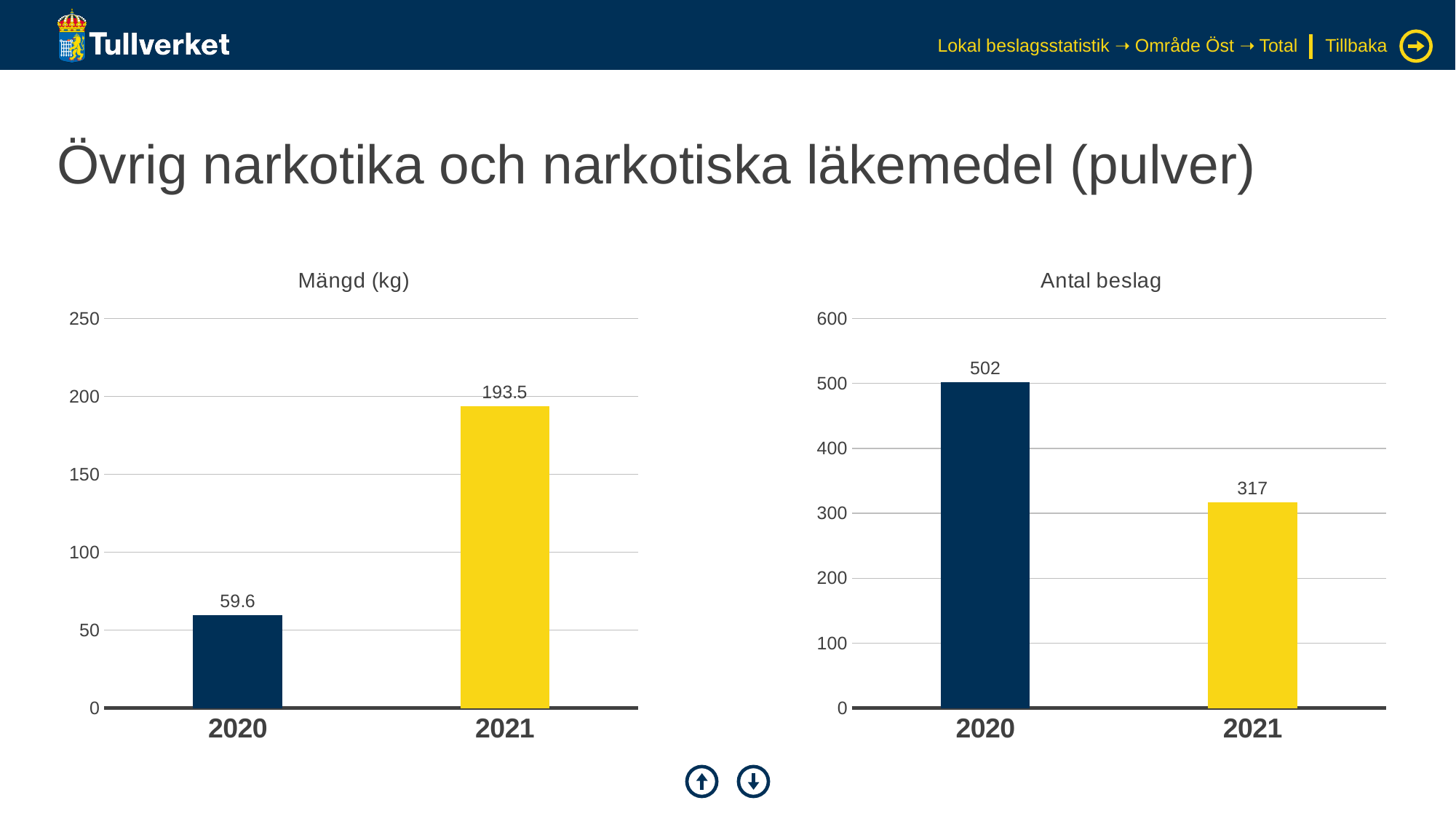
In the 'Antal beslag' chart, which year has the lowest value? 2021 In the 'Antal beslag' chart, what is the value for 2021? 317 In the 'Mängd (kg)' chart, what is the value for 2020? 59.6 In the 'Mängd (kg)' chart, what is the value for 2021? 193.5 How many bars are shown in the 'Mängd (kg)' chart? 2 In the 'Antal beslag' chart, what is the value for 2020? 502 What type of chart is the 'Antal beslag' chart? bar chart In the 'Antal beslag' chart, is the value for 2020 greater or less than 400? greater In the 'Antal beslag' chart, what is the difference between the 2020 and 2021 values? 185 In the 'Mängd (kg)' chart, what is the difference between the 2021 and 2020 values? 133.9 In the 'Mängd (kg)' chart, which year has the highest value? 2021 In the 'Antal beslag' chart, do the values rise or fall from 2020 to 2021? fall